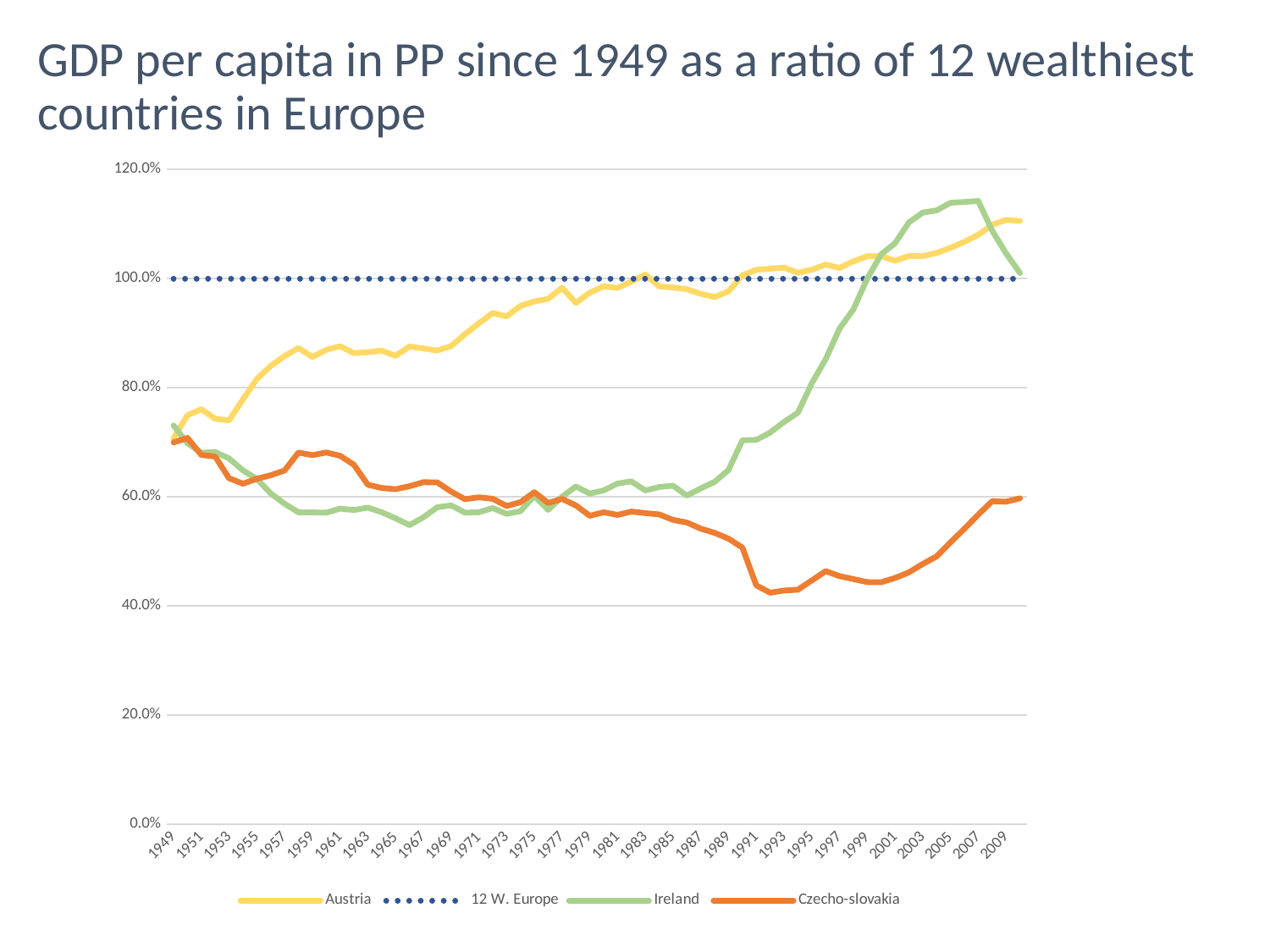
What kind of chart is shown on the slide? line chart Is the value for Ireland in 2007 greater or less than 100%? greater Which series has the highest value in 2005? Ireland Does the Austria series generally rise or fall from 1949 to 2009? rise What value does the 12 W. Europe series hold across all years? 100.0% Is the value for Austria in 1949 greater or less than 80%? less How many series does the legend list? 4 Which series are listed in the legend? Austria, 12 W. Europe, Ireland, Czecho-slovakia In 1959, which is larger: the value for Austria or the value for Ireland? Austria In 2009, which is larger: the value for Austria or the value for Czecho-slovakia? Austria Which series has the lowest value in 1999? Czecho-slovakia Is the value for Czecho-slovakia in 1993 greater or less than 60%? less